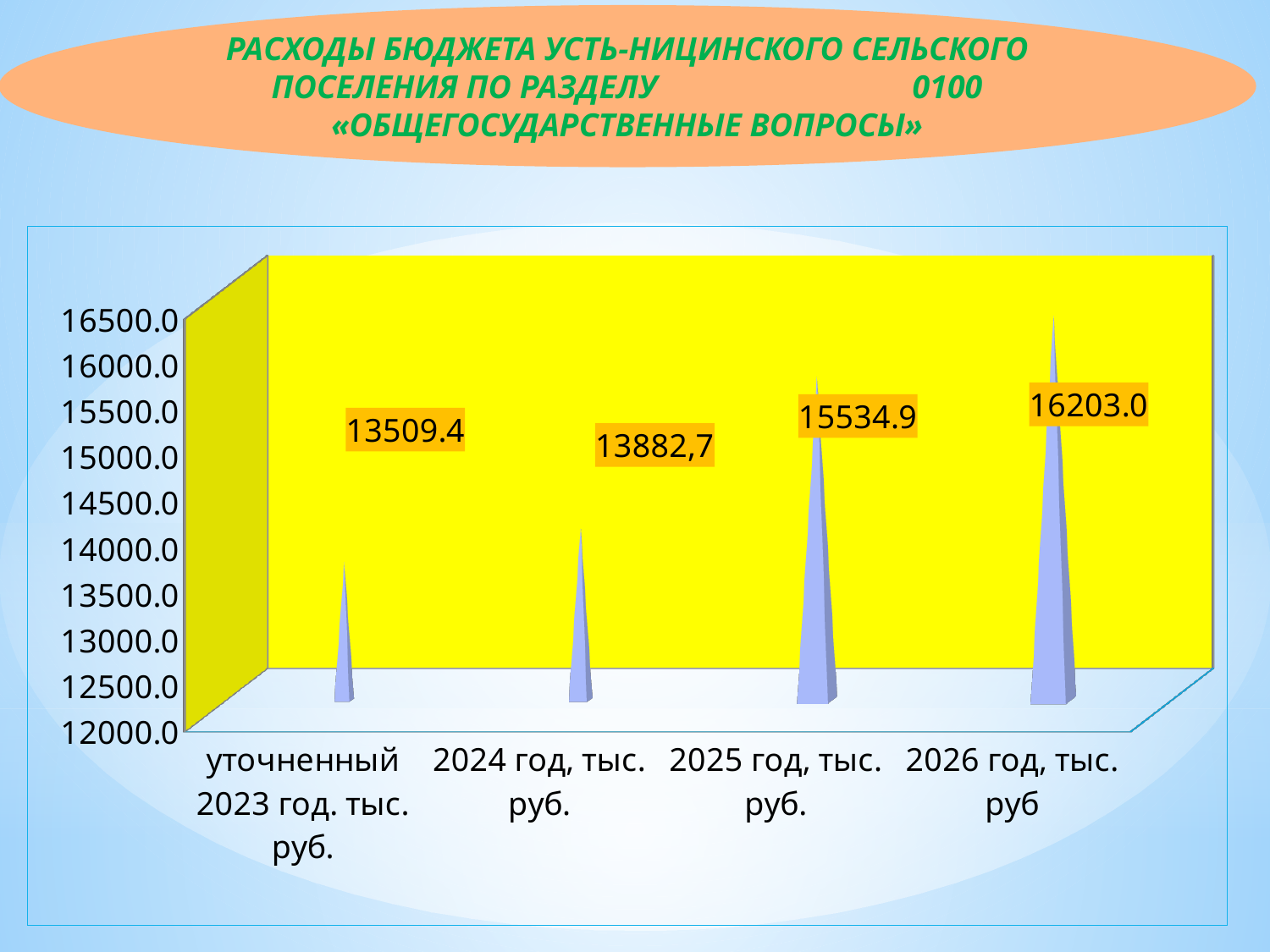
What is the value for уточненный 2023 год. тыс. руб.? 13509.4 Which category has the highest value? 2026 год, тыс. руб Which is larger, the value for 2024 год or the value for 2025 год? 2025 год, тыс. руб. Do the values rise or fall from left to right along the x axis? rise What is the difference between the values for 2025 год and 2024 год? 1652.2 What is the difference between the values for 2026 год and уточненный 2023 год? 2693.6 What is the value for 2026 год, тыс. руб? 16203.0 What is the value for 2024 год, тыс. руб.? 13882,7 What is the value for 2025 год, тыс. руб.? 15534.9 Which category has the lowest value? уточненный 2023 год. тыс. руб. What kind of chart is shown on the slide? bar chart How many categories are shown on the x axis? 4